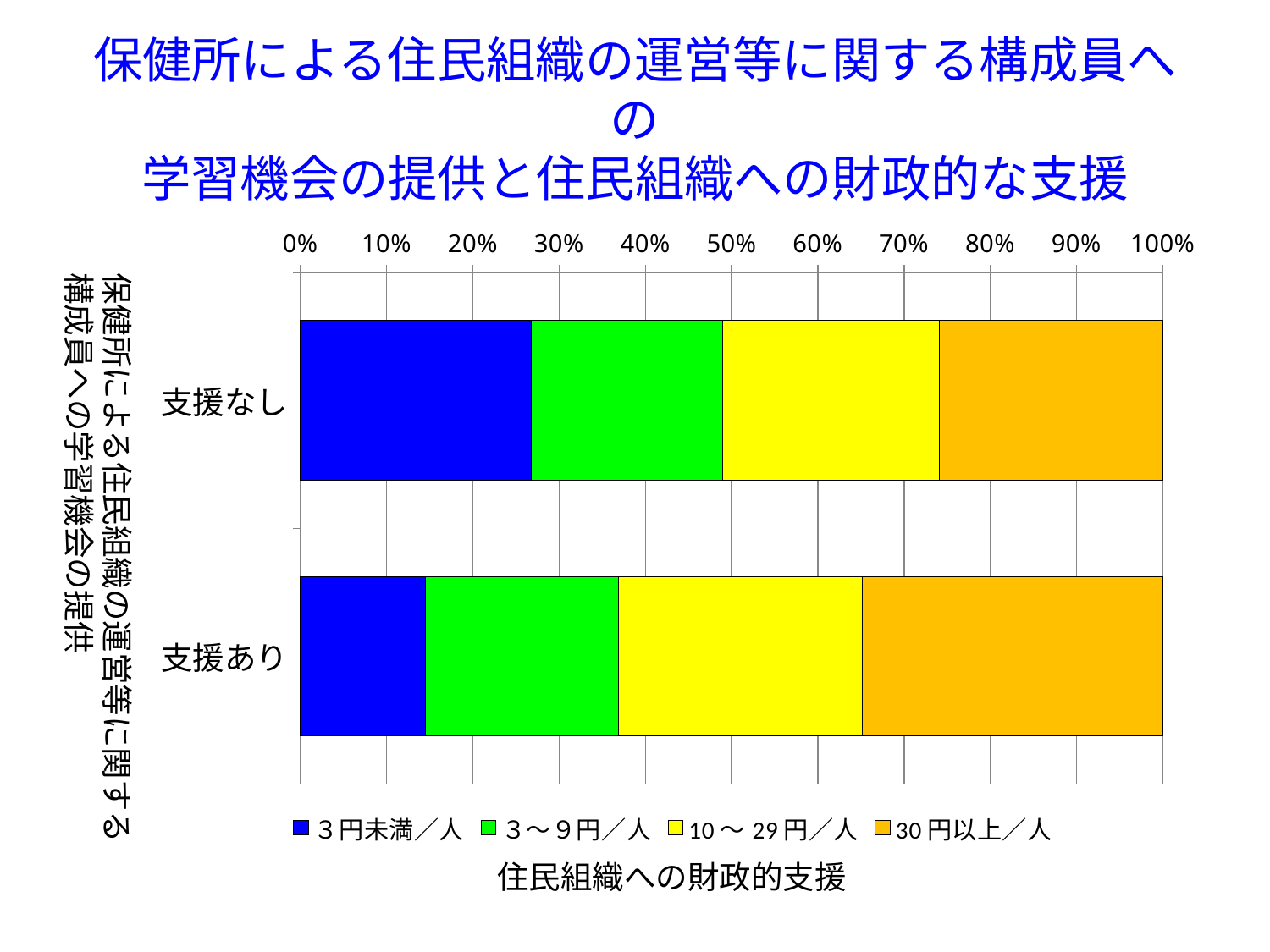
What is the total of the stacked bar for 支援あり? 100% Which colour represents the 10～29円／人 series in the legend? Yellow How many categories are plotted on the vertical axis? 2 Is the value of the 30円以上／人 segment for 支援あり greater or less than 30%? greater How many series does the legend list? 4 Which category has the larger ３円未満／人 segment, 支援なし or 支援あり? 支援なし What is the title shown below the legend? 住民組織への財政的支援 Is the value of the 30円以上／人 segment for 支援なし greater or less than 30%? less Which category has the larger 30円以上／人 segment, 支援なし or 支援あり? 支援あり What kind of chart is shown on the slide? Stacked bar chart Is the value of the ３円未満／人 segment for 支援あり greater or less than 20%? less